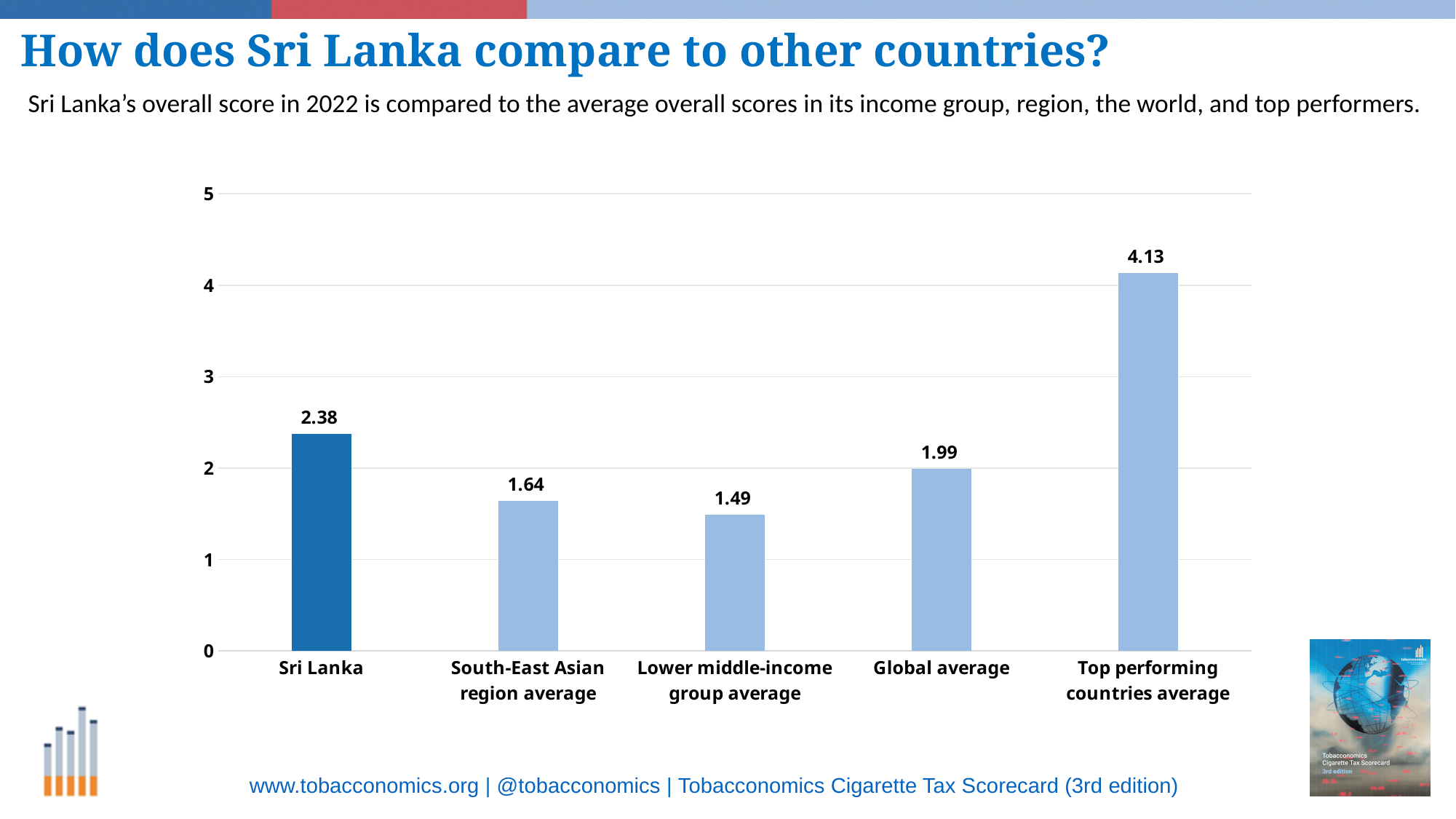
What is the value for the Lower middle-income group average? 1.49 Is the value for the Top performing countries average greater or less than 4? greater What is the overall score for Sri Lanka? 2.38 Which category has the lowest value? Lower middle-income group average Which category has the highest value? Top performing countries average What is the value for the Top performing countries average? 4.13 What is the difference between the Top performing countries average and Sri Lanka's score? 1.75 Which is larger, Sri Lanka's score or the Global average? Sri Lanka What is the value for the Global average? 1.99 What is the difference between Sri Lanka's score and the South-East Asian region average? 0.74 How many categories are shown in the chart? 5 What kind of chart is shown on the slide? Bar chart